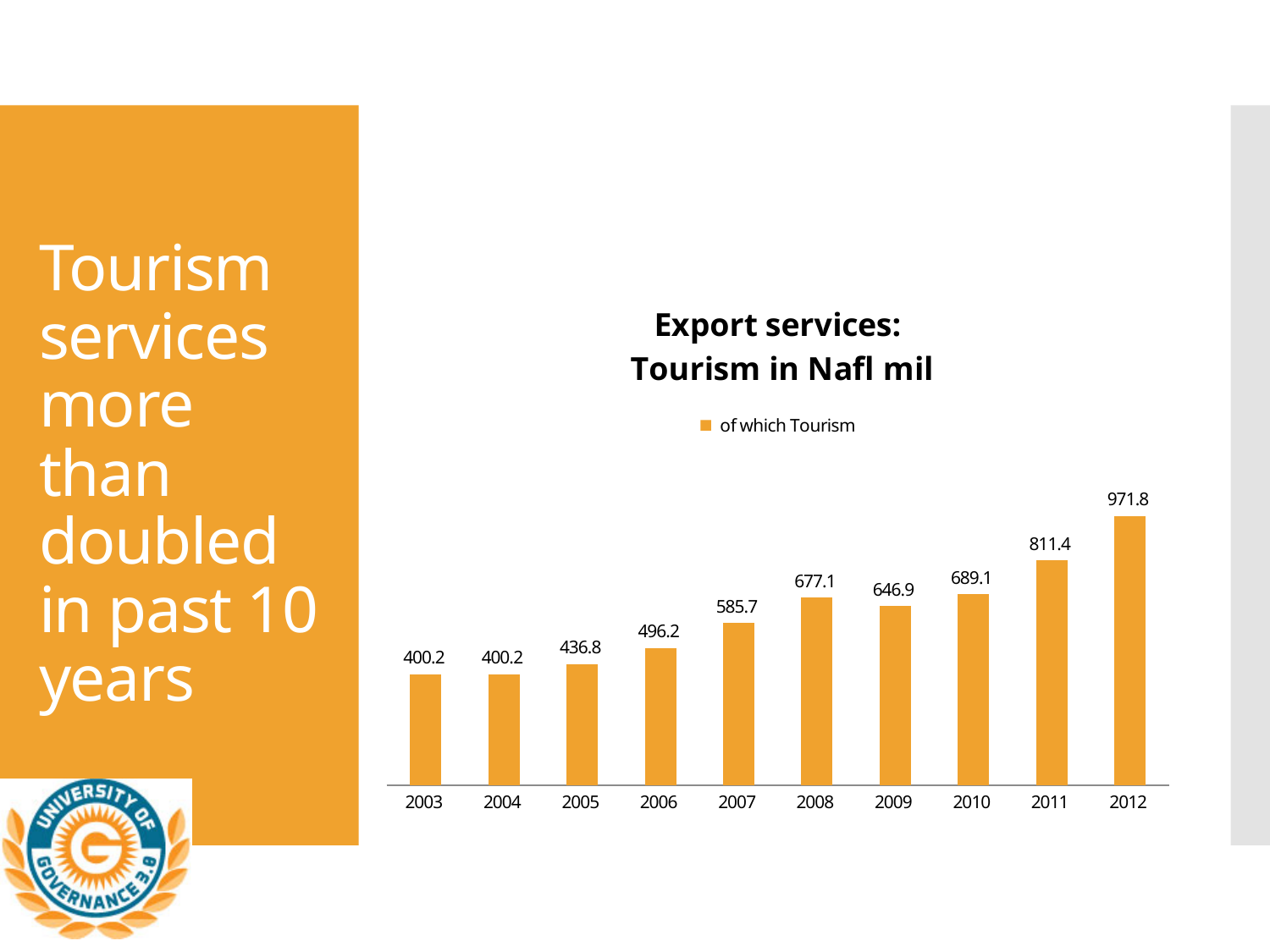
What is the value for 2012? 971.8 What kind of chart is shown? bar chart What is the value for 2007? 585.7 How many years are shown on the x axis? 10 What is the difference between the values for 2008 and 2009? 30.2 What is the difference between the values for 2012 and 2003? 571.6 What is the value for 2003? 400.2 Which is larger, the value for 2008 or the value for 2009? 2008 Do the values generally rise or fall from 2003 to 2012? rise What is the title of the chart? Export services: Tourism in Nafl mil How many series does the legend list? 1 Which year has the highest value? 2012